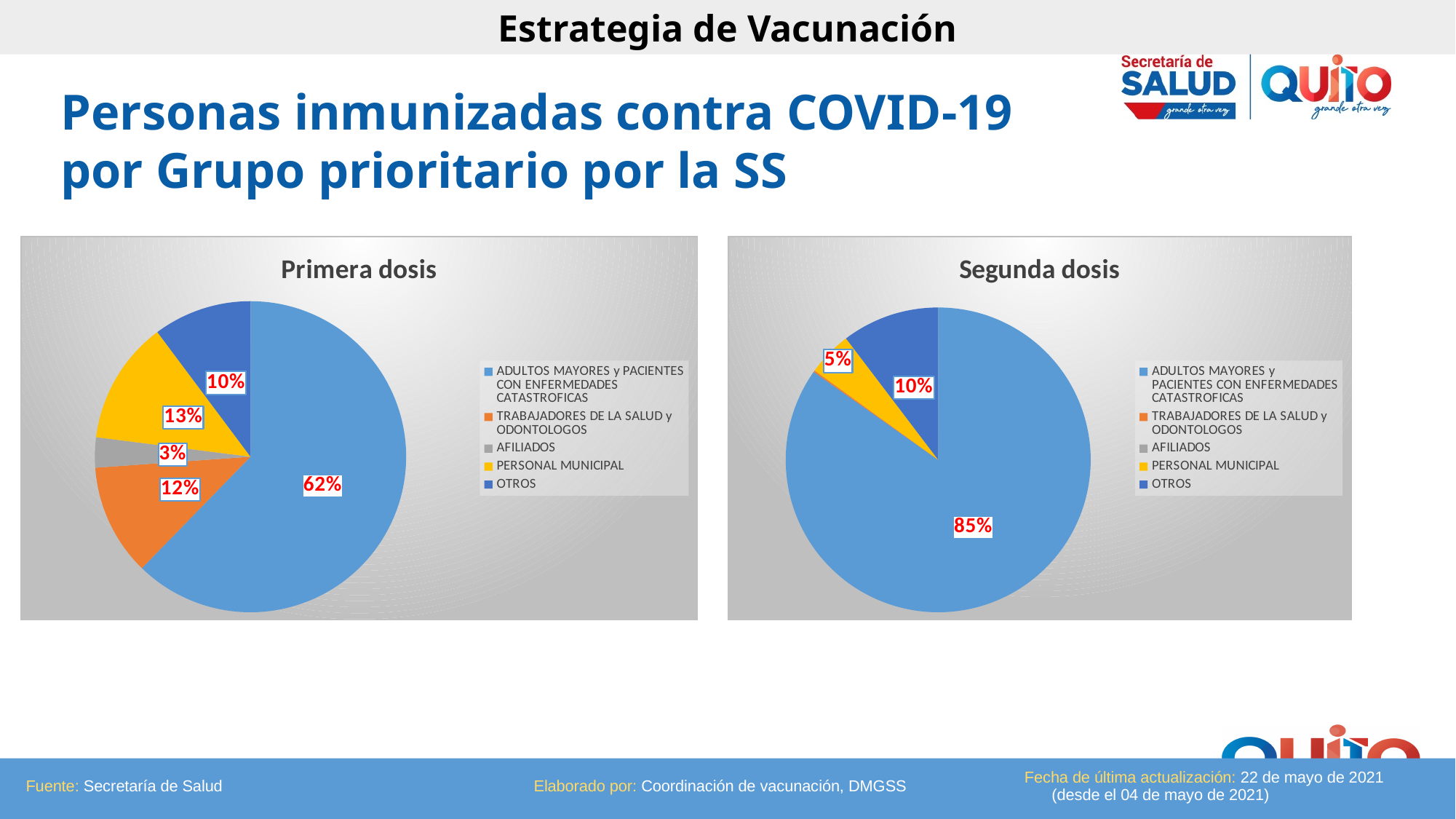
In the "Primera dosis" chart, what is the difference between the PERSONAL MUNICIPAL and TRABAJADORES DE LA SALUD y ODONTOLOGOS shares? 1% In the "Primera dosis" chart, what percentage is shown for PERSONAL MUNICIPAL? 13% In the "Segunda dosis" chart, what share of the pie is ADULTOS MAYORES y PACIENTES CON ENFERMEDADES CATASTROFICAS? 85% In the "Primera dosis" chart, which group has the smallest slice? AFILIADOS In the "Primera dosis" chart, what percentage is shown for AFILIADOS? 3% In the "Segunda dosis" chart, which group has the largest slice? ADULTOS MAYORES y PACIENTES CON ENFERMEDADES CATASTROFICAS What type of chart is the "Primera dosis" chart? Pie chart In the "Segunda dosis" chart, what percentage is shown for PERSONAL MUNICIPAL? 5% How many entries does the legend of the "Segunda dosis" chart list? 5 In the "Segunda dosis" chart, what percentage is shown for OTROS? 10% In the "Primera dosis" chart, what share of the pie is ADULTOS MAYORES y PACIENTES CON ENFERMEDADES CATASTROFICAS? 62% In the "Primera dosis" chart, which is larger: the share for OTROS or the share for AFILIADOS? OTROS